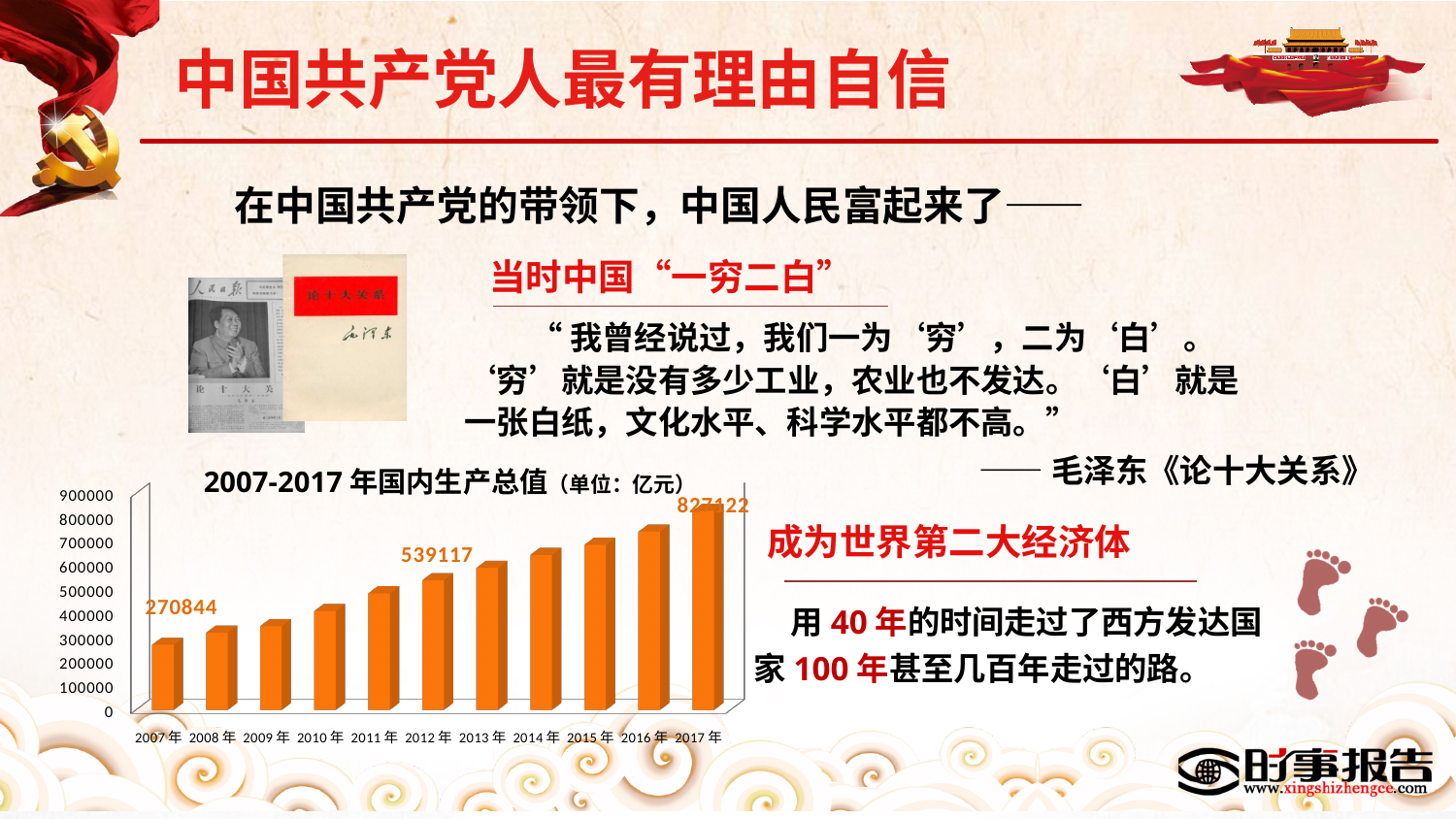
How many years (categories) are plotted in the chart? 11 Which year has the highest value in the chart? 2017 年 What is the value for 2017 in the chart? 827122 What is the value for 2012 in the chart? 539117 What is the difference between the 2012 value and the 2007 value? 268273 Is the value for 2010 greater or less than 500000? less Which year has the lowest value in the chart? 2007 年 Do the values rise or fall from 2007 to 2017? rise What is the title of the chart? 2007-2017 年国内生产总值（单位：亿元） What type of chart is shown on the slide? bar chart What is the value for 2007 in the chart? 270844 What is the difference between the 2017 value and the 2007 value? 556278